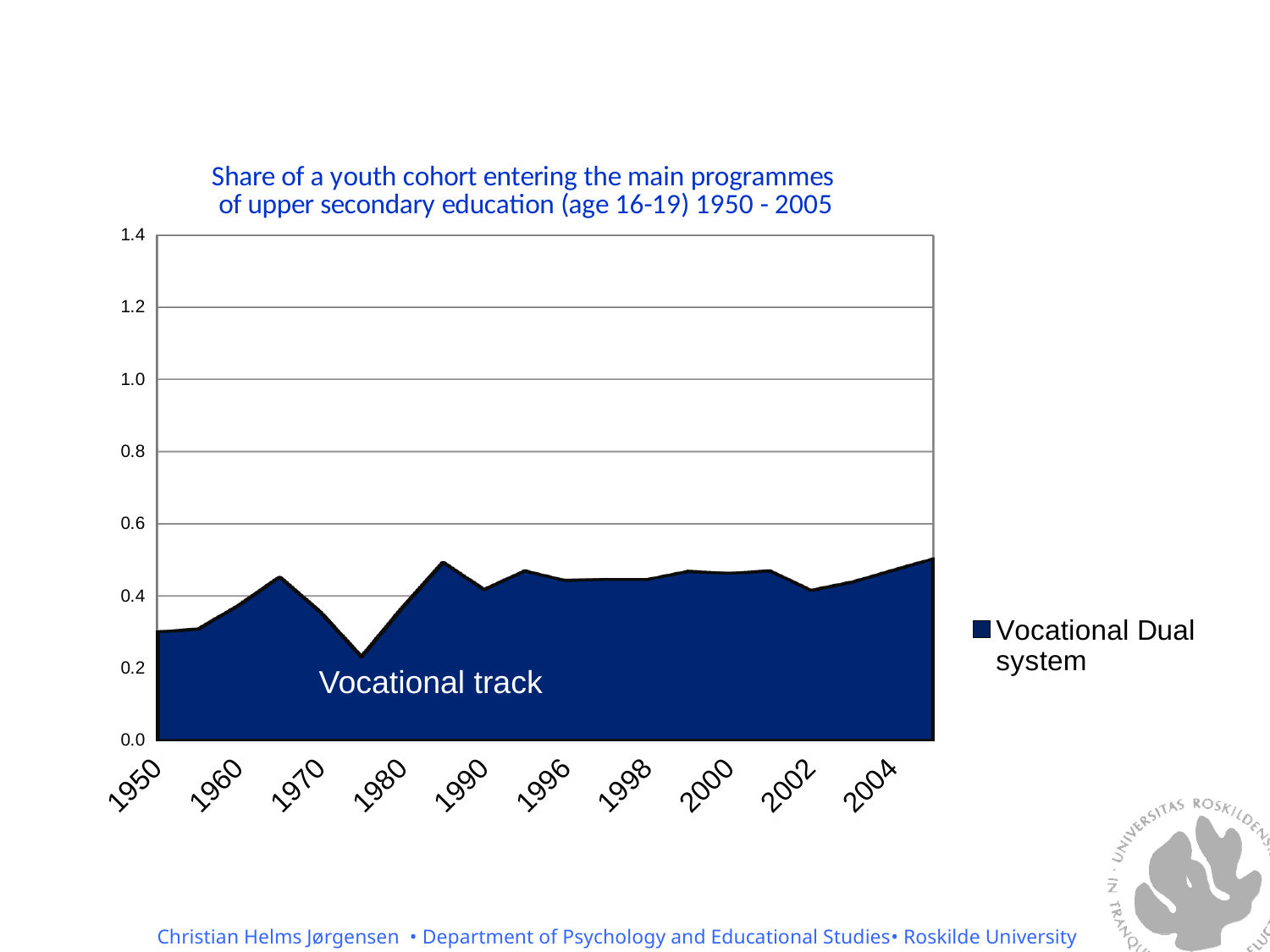
Is the value for 2004 greater or less than 0.4? greater How many year labels are shown on the x axis? 10 What kind of chart is shown on the slide? area chart Is the value for 2000 greater or less than 0.6? less What is the name of the series shown in the legend? Vocational Dual system Is the value for 1950 greater or less than 0.4? less How many series does the legend list? 1 Overall, does the share rise or fall from 1950 to the end of the series? rise What is the title of the chart? Share of a youth cohort entering the main programmes of upper secondary education (age 16-19) 1950 - 2005 Which is larger, the value for 1950 or the value for 2004? 2004